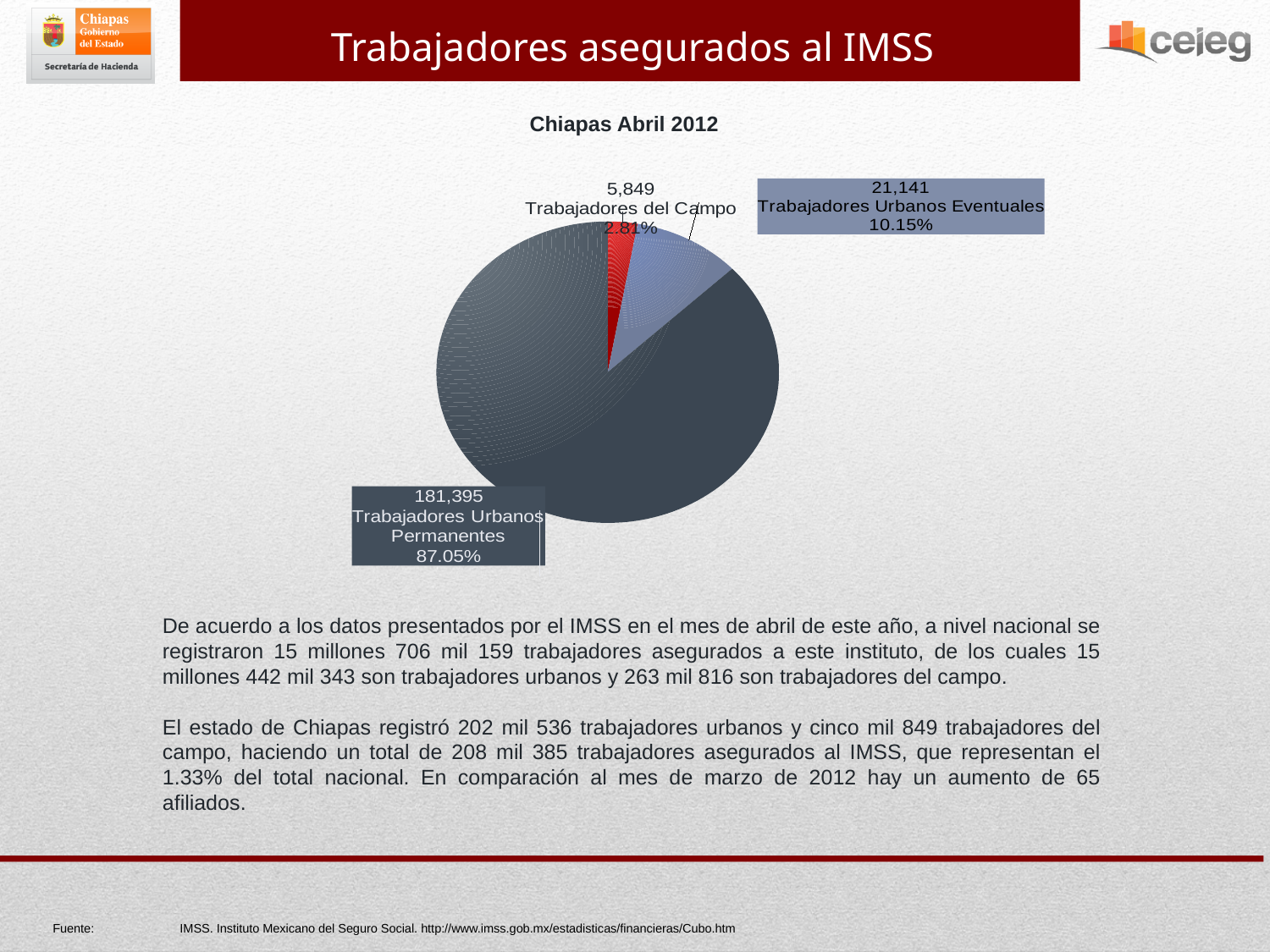
How many slices does the pie chart have? 3 What share of the pie does Trabajadores del Campo represent? 2.81% What is the value for Trabajadores Urbanos Permanentes? 181,395 What share of the pie does Trabajadores Urbanos Eventuales represent? 10.15% What is the value for Trabajadores del Campo? 5,849 Which category has the largest slice? Trabajadores Urbanos Permanentes What kind of chart is shown on the slide? Pie chart What share of the pie does Trabajadores Urbanos Permanentes represent? 87.05% What is the difference between the values for Trabajadores Urbanos Eventuales and Trabajadores del Campo? 15,292 What is the title of the chart? Chiapas Abril 2012 Which category has the smallest slice? Trabajadores del Campo What is the value for Trabajadores Urbanos Eventuales? 21,141